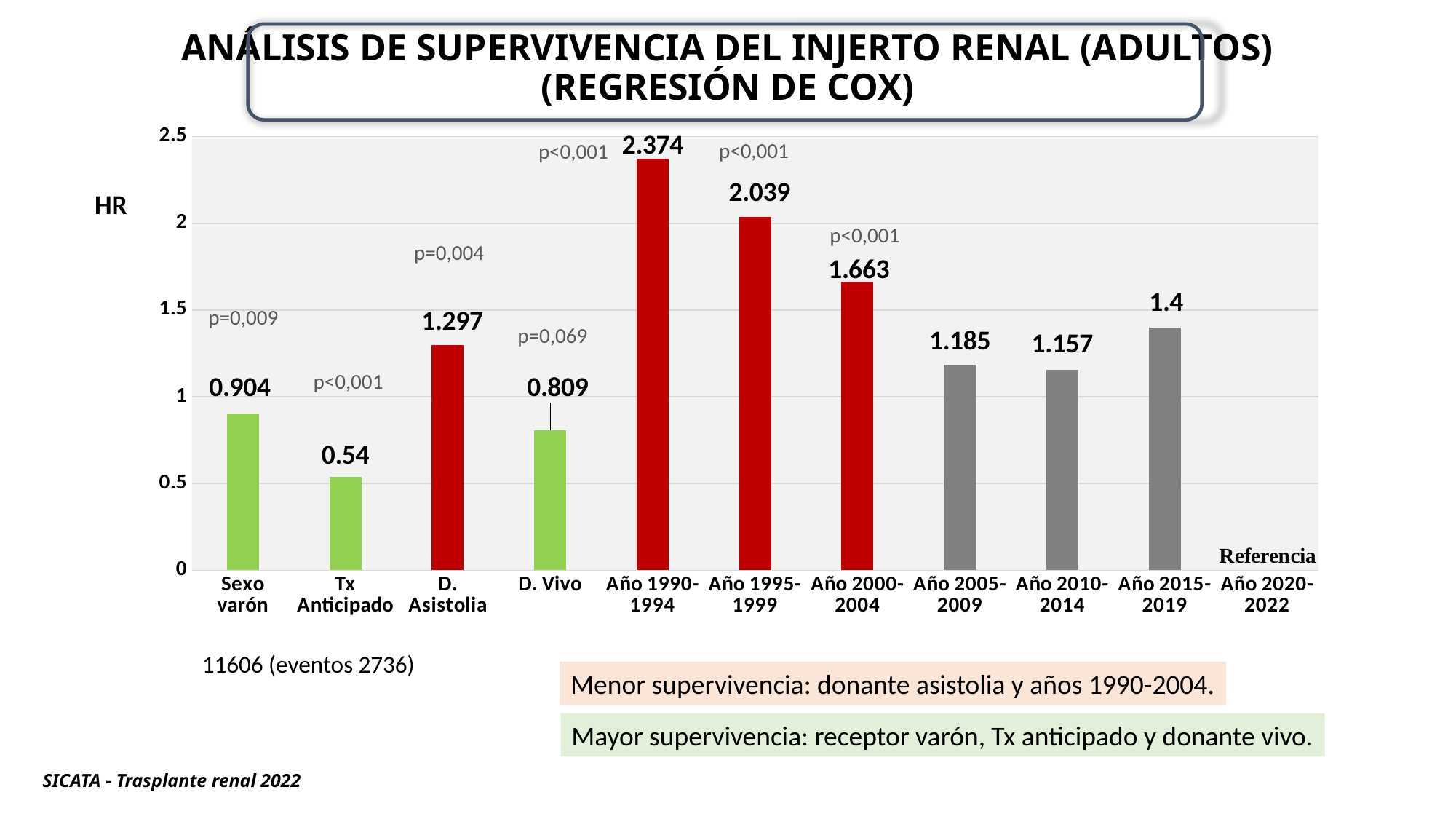
What p-value is shown above the D. Vivo bar? p=0,069 What is the difference between the HR values for Año 1990-1994 and Año 2000-2004? 0.711 What is the HR value for Tx Anticipado? 0.54 What is the HR value for Año 1995-1999? 2.039 How many categories are shown on the x axis of the chart? 11 Is the HR value for Año 2015-2019 greater or less than 1.5? less What kind of chart is shown on the slide? bar chart Which has a larger HR value, Sexo varón or D. Vivo? Sexo varón What is the HR value for D. Asistolia? 1.297 Do the HR values rise or fall from Año 1990-1994 to Año 2000-2004? fall Which category has the lowest HR value? Tx Anticipado Which category has the highest HR value? Año 1990-1994